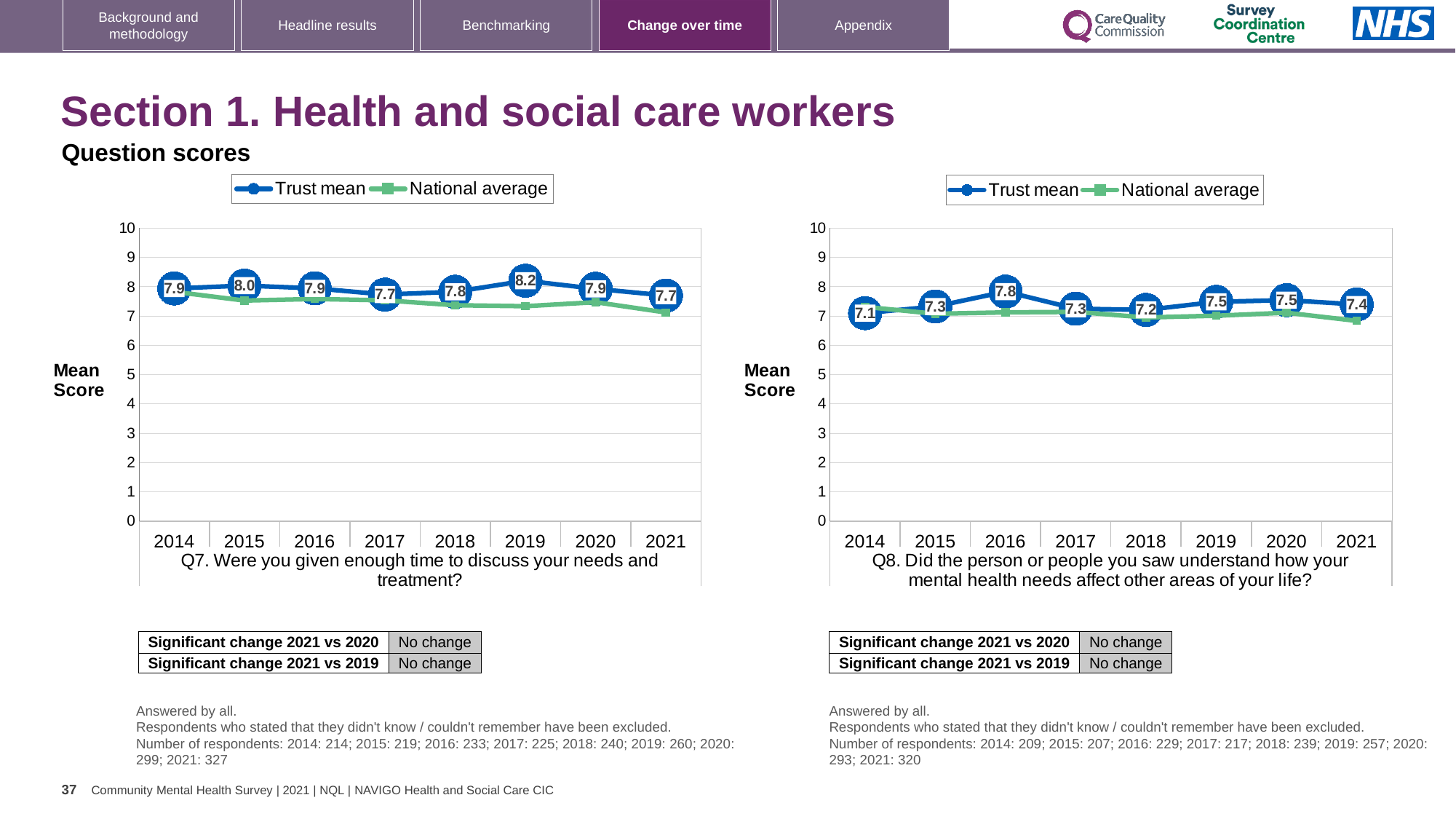
In the Q7 chart on the left, which year has the highest Trust mean? 2019 What type of chart is the Q8 chart on the right? Line chart In the Q8 chart on the right, which year has the lowest Trust mean? 2014 In the Q8 chart on the right, which year has the highest Trust mean? 2016 How many years are shown on the x axis of the Q8 chart on the right? 8 In the Q8 chart on the right, is the Trust mean higher in 2016 or in 2018? 2016 In the Q8 chart on the right, does the Trust mean rise or fall from 2014 to 2016? Rise In the Q7 chart on the left, is the National average for 2021 greater or less than 8? less In the Q7 chart on the left, what is the difference between the Trust mean in 2019 and in 2021? 0.5 In the Q8 chart on the right, what is the Trust mean for 2014? 7.1 How many series does the legend of the Q7 chart on the left list? 2 In the Q7 chart on the left, what is the Trust mean for 2019? 8.2